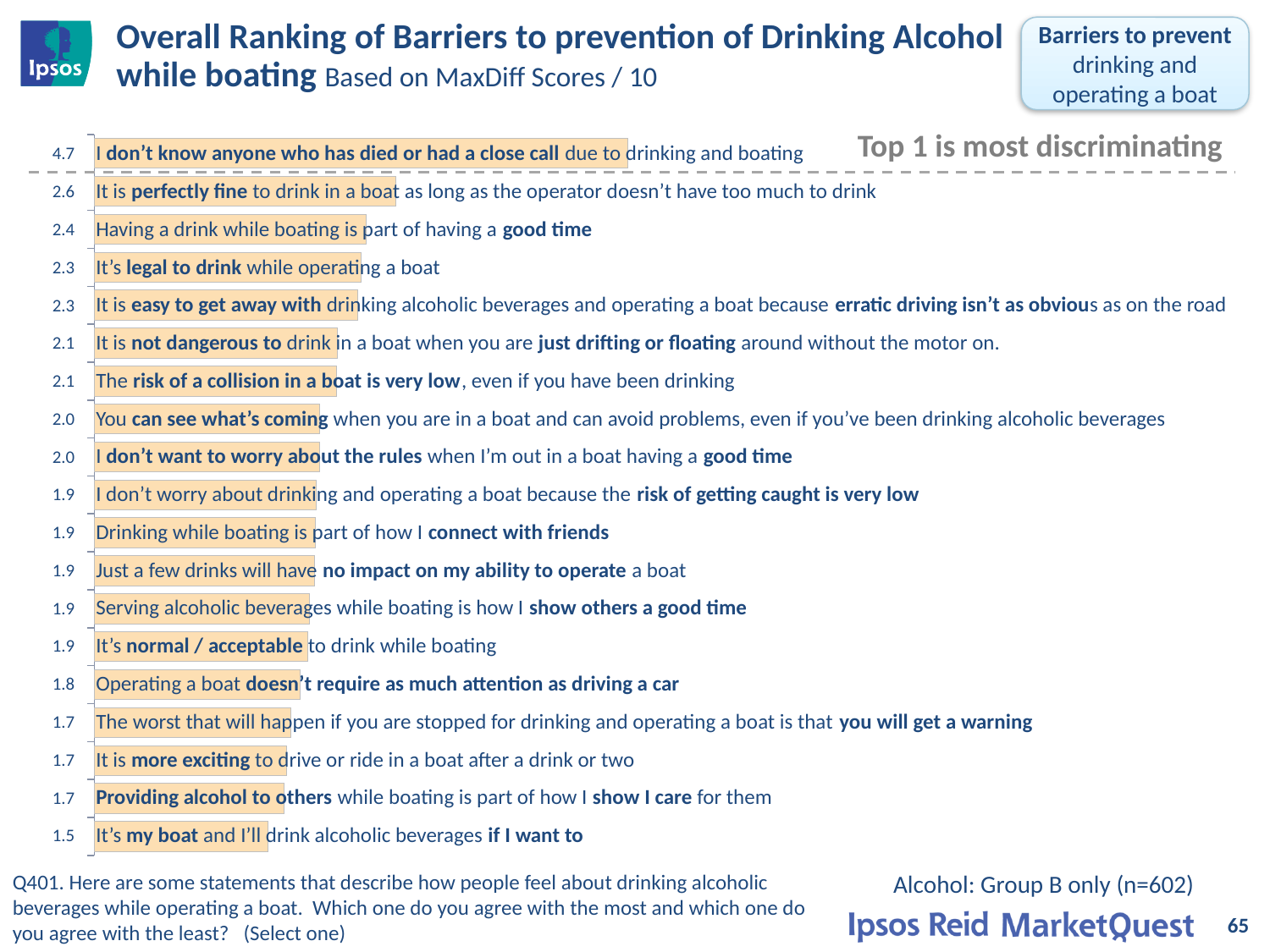
Which has a higher MaxDiff score: "Having a drink while boating is part of having a good time" or "Drinking while boating is part of how I connect with friends"? Having a drink while boating is part of having a good time Which statement has the lowest MaxDiff score? It's my boat and I'll drink alcoholic beverages if I want to What type of chart is used on this slide? Bar chart What is the MaxDiff score for "It is perfectly fine to drink in a boat as long as the operator doesn't have too much to drink"? 2.6 What is the MaxDiff score for "Operating a boat doesn't require as much attention as driving a car"? 1.8 Which statement has the highest MaxDiff score? I don't know anyone who has died or had a close call due to drinking and boating What is the difference between the highest MaxDiff score (4.7) and the second highest (2.6)? 2.1 What is the MaxDiff score for "It's legal to drink while operating a boat"? 2.3 How many statements (bars) are shown in the chart? 19 What is the sample size noted on the slide for Alcohol: Group B only? n=602 What is the MaxDiff score for "It's my boat and I'll drink alcoholic beverages if I want to"? 1.5 What is the MaxDiff score for the statement "I don't know anyone who has died or had a close call due to drinking and boating"? 4.7